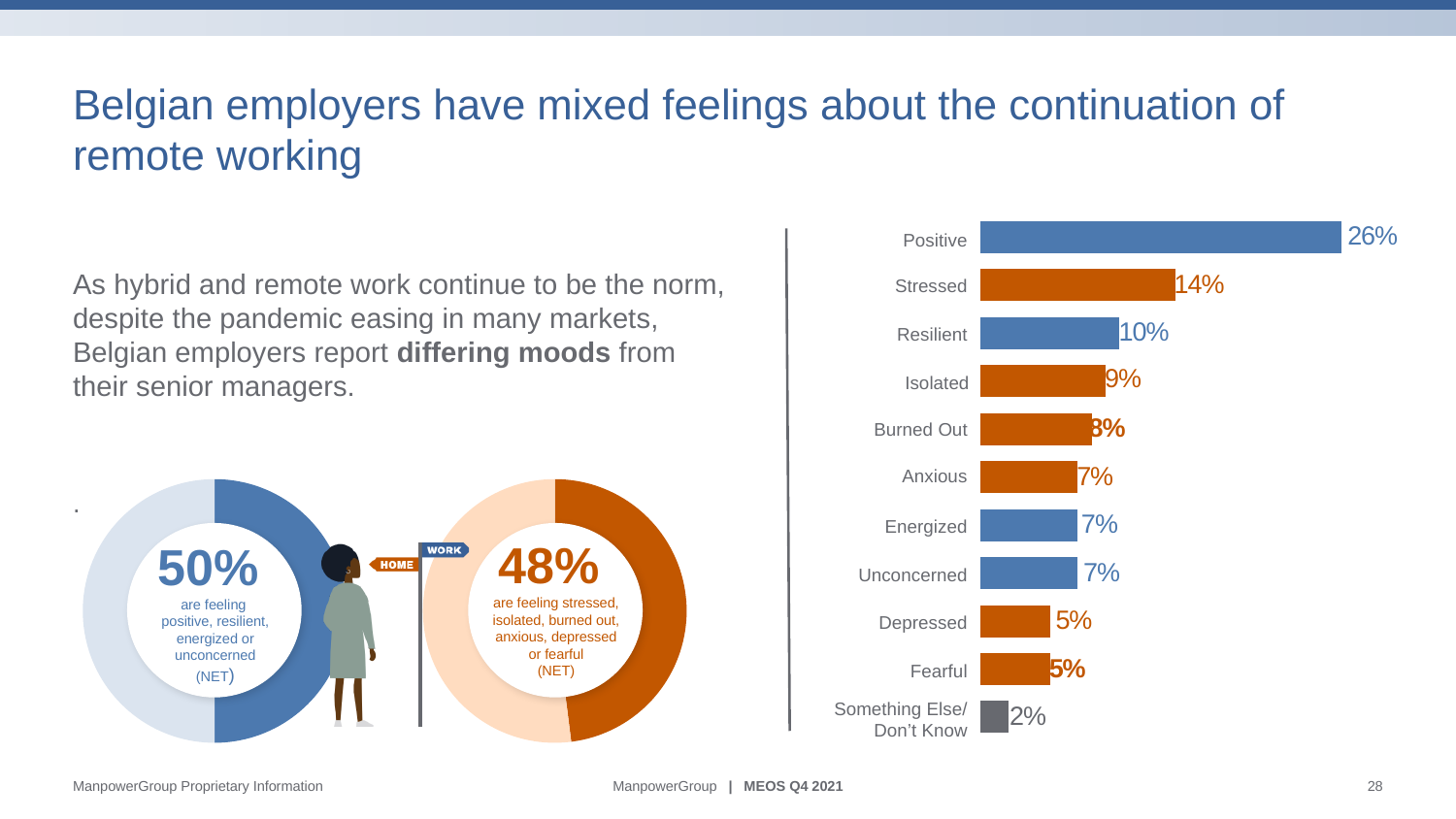
In the bar chart on the right, which is larger, the value for Resilient or the value for Burned Out? Resilient In the right donut chart, what percentage of employers say senior managers are feeling stressed, isolated, burned out, anxious, depressed or fearful (NET)? 48% In the bar chart on the right, what is the value for Isolated? 9% What type of chart is shown on the right side of the slide? Bar chart How many categories are shown in the bar chart on the right? 11 In the bar chart on the right, what percentage of Belgian employers report their senior managers are feeling Positive? 26% In the bar chart on the right, which category has the highest value? Positive In the bar chart on the right, which category has the lowest value? Something Else/Don't Know In the bar chart on the right, what is the value for Stressed? 14% In the bar chart on the right, what is the difference between the values for Positive and Stressed? 12% In the left donut chart, what percentage of employers say senior managers are feeling positive, resilient, energized or unconcerned (NET)? 50% In the bar chart on the right, what is the value for Something Else/Don't Know? 2%